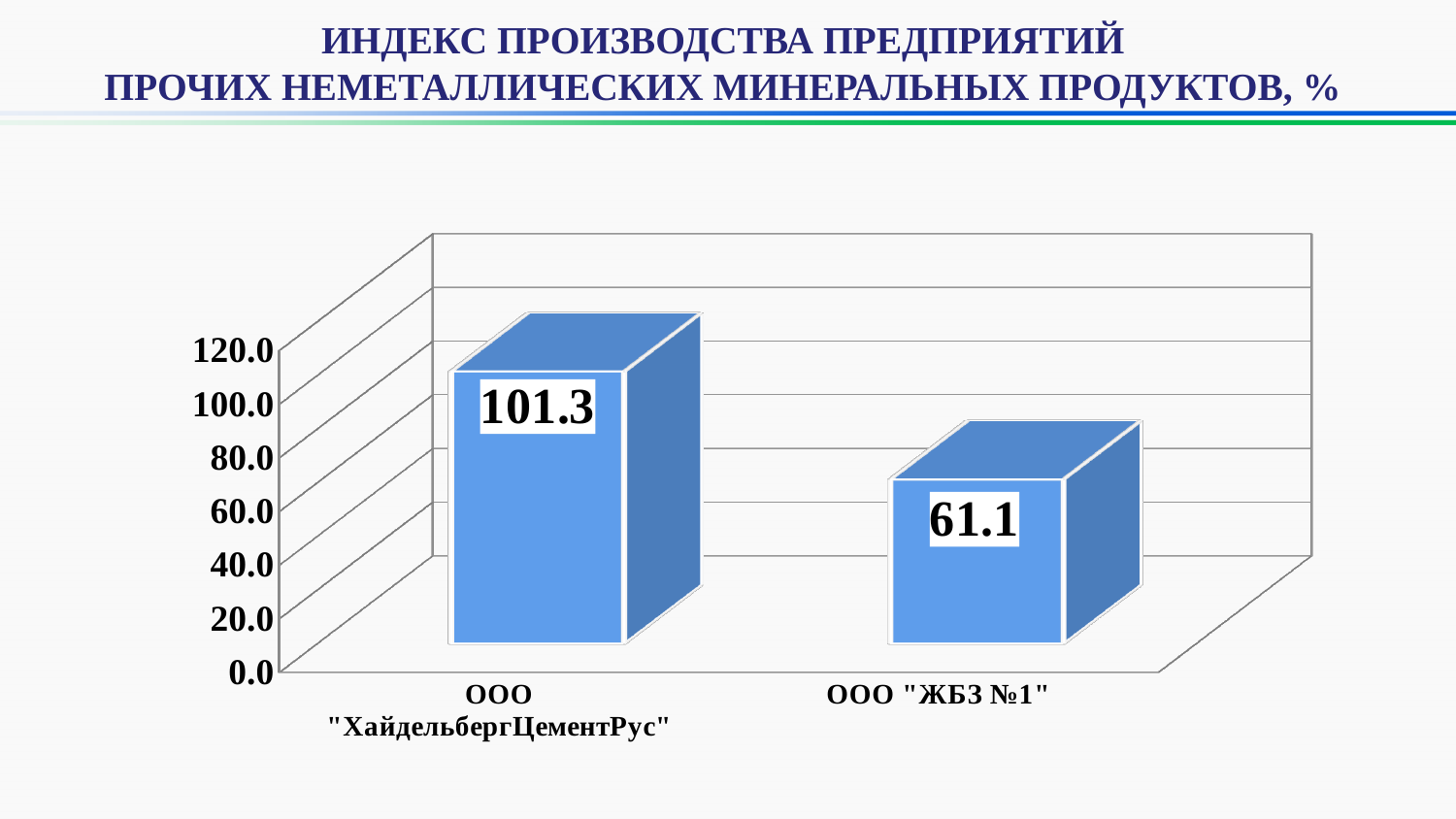
How many enterprises are shown on the chart? 2 What is the difference between the production index of ООО "ХайдельбергЦементРус" and ООО "ЖБЗ №1"? 40.2 What kind of chart is shown on the slide? Bar chart What is the production index value for ООО "ХайдельбергЦементРус"? 101.3 What unit is indicated in the chart title? % What is the maximum value shown on the vertical axis? 120.0 Which enterprise has the lowest production index? ООО "ЖБЗ №1" Which is larger: the value for ООО "ХайдельбергЦементРус" or the value for ООО "ЖБЗ №1"? ООО "ХайдельбергЦементРус" What is the production index value for ООО "ЖБЗ №1"? 61.1 Is the value for ООО "ЖБЗ №1" greater or less than 80.0? less Is the value for ООО "ХайдельбергЦементРус" greater or less than 100.0? greater Which enterprise has the highest production index? ООО "ХайдельбергЦементРус"